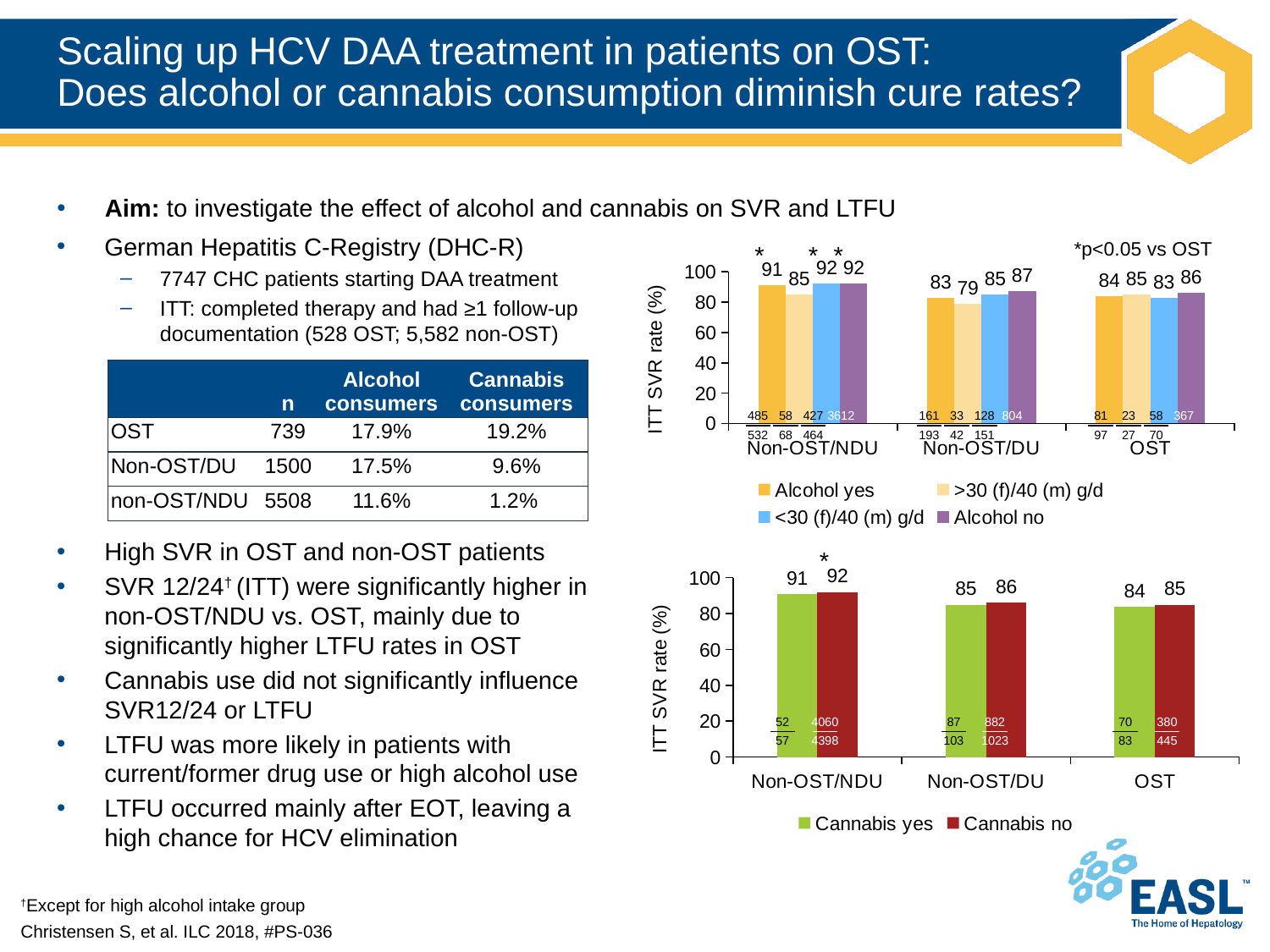
In the top chart (alcohol), what is the ITT SVR rate for the 'Alcohol yes' group in the Non-OST/NDU category? 91 In the bottom chart (cannabis), what is the ITT SVR rate for 'Cannabis no' in the Non-OST/NDU category? 92 In the top chart (alcohol), what is the ITT SVR rate for the '>30 (f)/40 (m) g/d' group in the Non-OST/DU category? 79 How many series does the legend of the top chart (alcohol) list? 4 In the bottom chart (cannabis), what is the ITT SVR rate for 'Cannabis yes' in the OST category? 84 In the bottom chart (cannabis), what is the difference between 'Cannabis no' and 'Cannabis yes' in the Non-OST/DU category? 1 In the bottom chart (cannabis), which category has the highest 'Cannabis yes' ITT SVR rate? Non-OST/NDU What type of chart is the bottom chart (cannabis)? Bar chart In the top chart (alcohol), what is the difference between the 'Alcohol no' and 'Alcohol yes' ITT SVR rates in the Non-OST/DU category? 4 In the top chart (alcohol), what is the ITT SVR rate for the 'Alcohol no' group in the OST category? 86 How many categories are shown on the x axis of the bottom chart (cannabis)? 3 In the top chart (alcohol), which group has the lowest ITT SVR rate in the Non-OST/DU category? >30 (f)/40 (m) g/d